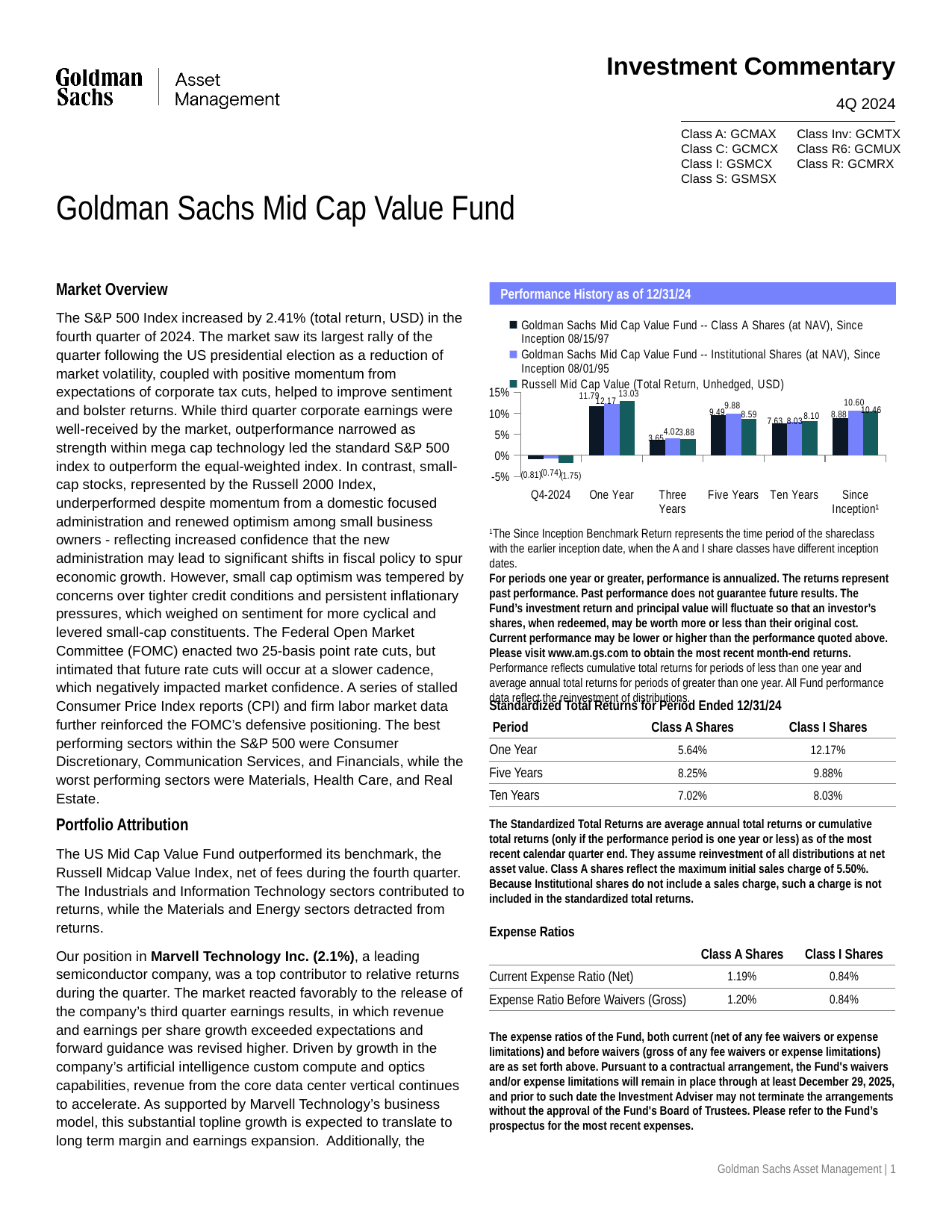
In the Performance History chart, for which period is the Class A Shares return lowest? Q4-2024 In the Performance History chart, what is the Q4-2024 value for the Russell Mid Cap Value index? (1.75) How many time periods are shown along the x axis of the Performance History chart? 6 In the Performance History chart, what is the Five Years value for the Institutional Shares (at NAV)? 9.88 In the Performance History chart, what is the One Year value for the Class A Shares (at NAV)? 11.79 In the Performance History chart, what is the Since Inception value for the Russell Mid Cap Value index? 10.46 What kind of chart is shown under 'Performance History as of 12/31/24'? Bar chart How many series does the legend of the Performance History chart list? 3 In the Performance History chart, what is the difference between the One Year return of the Russell Mid Cap Value index and the Class A Shares? 1.24 In the Performance History chart, is the One Year value for the Russell Mid Cap Value index greater or less than 10%? greater In the Performance History chart, for which period is the Russell Mid Cap Value return highest? One Year In the Performance History chart, for Five Years, which is larger: the Institutional Shares return or the Russell Mid Cap Value return? Institutional Shares